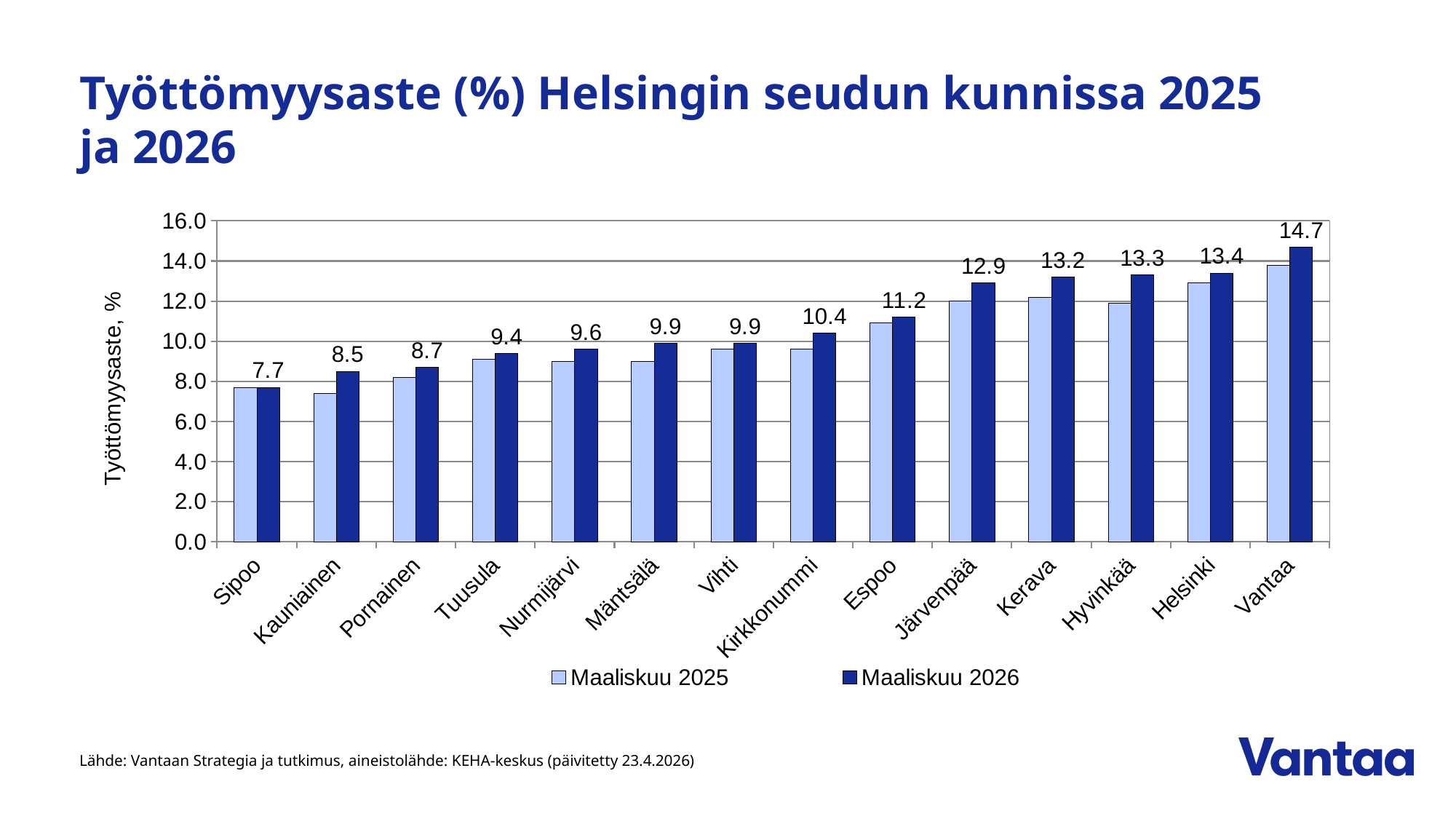
How many municipalities are shown on the x axis? 14 How many series does the legend list? 2 What is the unemployment rate for Espoo in Maaliskuu 2026? 11.2 What is the unemployment rate for Vantaa in Maaliskuu 2026? 14.7 Which municipality has the lowest unemployment rate in Maaliskuu 2026? Sipoo What is the difference between the Maaliskuu 2026 unemployment rates of Espoo and Sipoo? 3.5 What kind of chart is shown on the slide? bar chart What is the unemployment rate for Kirkkonummi in Maaliskuu 2026? 10.4 Which municipality has the highest unemployment rate in Maaliskuu 2026? Vantaa Is the Maaliskuu 2025 value for Kauniainen greater or less than 8.0? less Which has a higher Maaliskuu 2026 unemployment rate, Kerava or Järvenpää? Kerava What is the difference between the Maaliskuu 2026 unemployment rates of Vantaa and Helsinki? 1.3